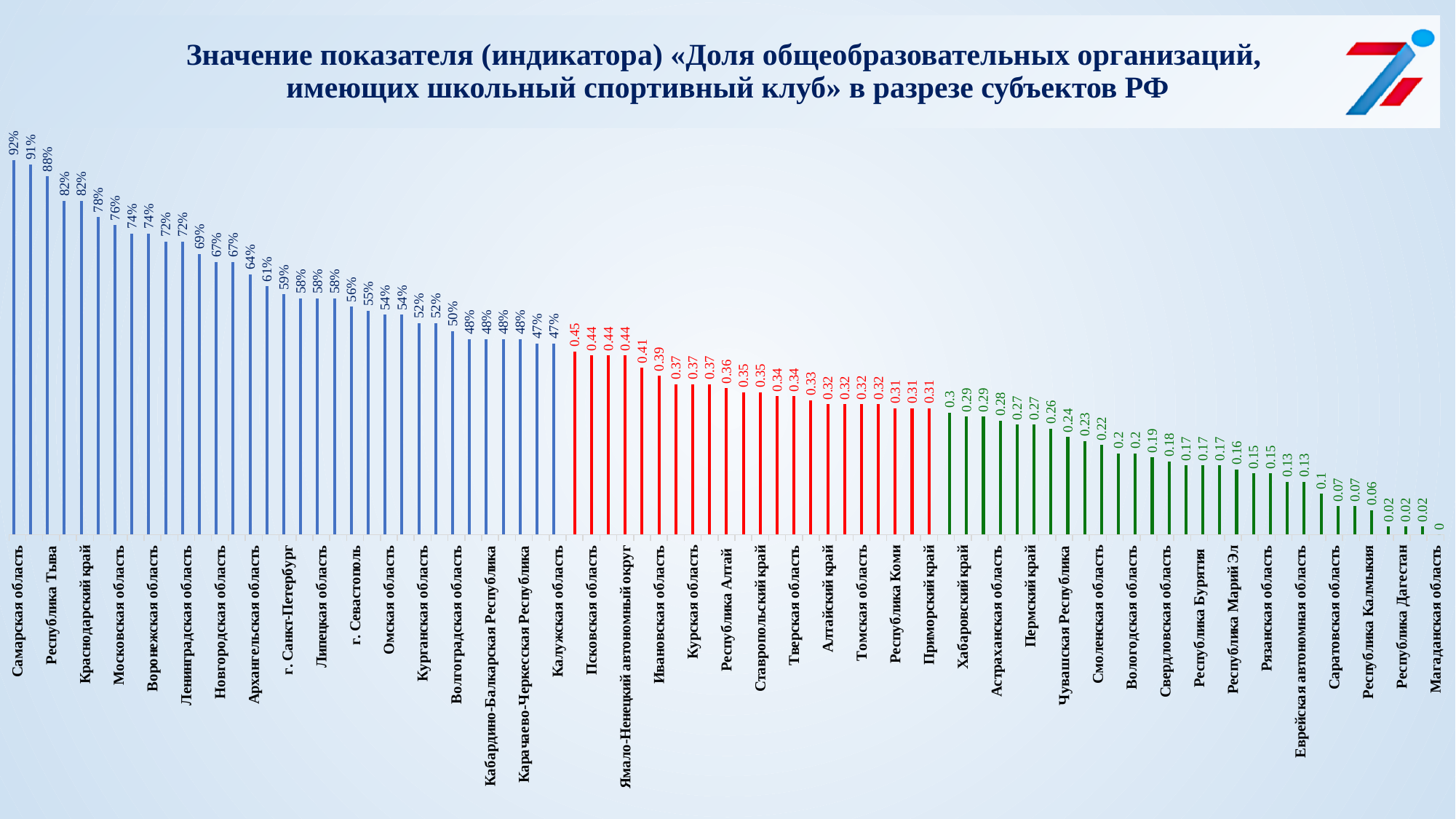
What is the value shown for Магаданская область? 0 What is the difference between the values for Самарская область and Республика Тыва? 4% Which has a larger value, Краснодарский край or Московская область? Краснодарский край What kind of chart is shown on the slide? bar chart What is the value shown for Псковская область? 0.44 Do the values rise or fall from left to right along the x axis? fall How many different bar colours are used in the chart? 3 What is the value shown for Калужская область? 47% Which region has the highest value in the chart? Самарская область What is the value shown for Самарская область? 92% What is the value shown for Республика Тыва? 88% Which region has the lowest value in the chart? Магаданская область